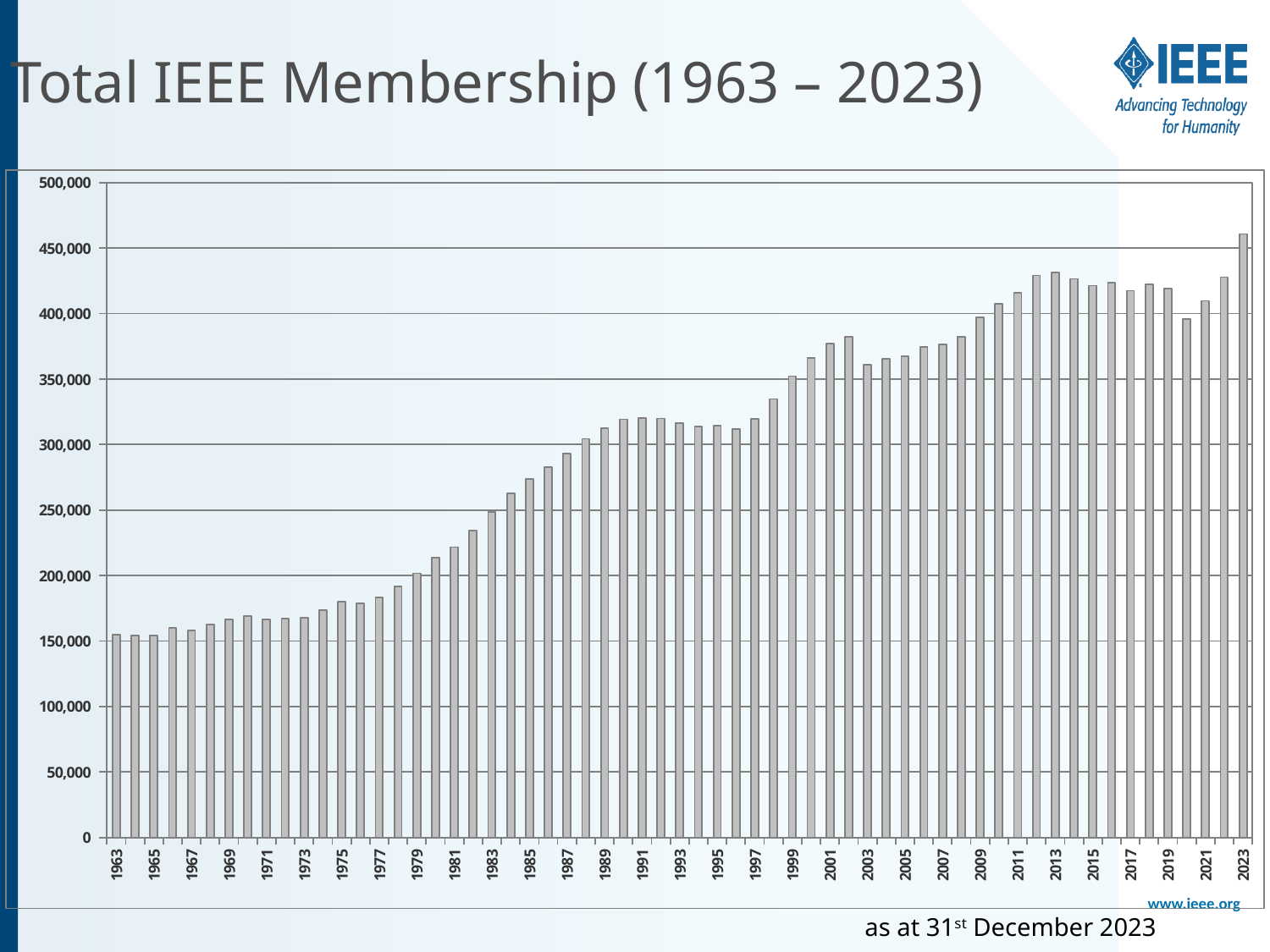
Is the membership value for 1997 greater or less than 350,000? less Is the membership value for 2013 greater or less than 400,000? greater Which year has the highest total IEEE membership? 2023 Is the membership value for 1975 greater or less than 200,000? less Overall, does total IEEE membership rise or fall from 1963 to 2023? Rise What kind of chart is shown on the slide? Bar chart What is the title of the chart? Total IEEE Membership (1963 – 2023) Which year has the larger membership, 1991 or 1999? 1999 Which year has the larger membership, 2013 or 2020? 2013